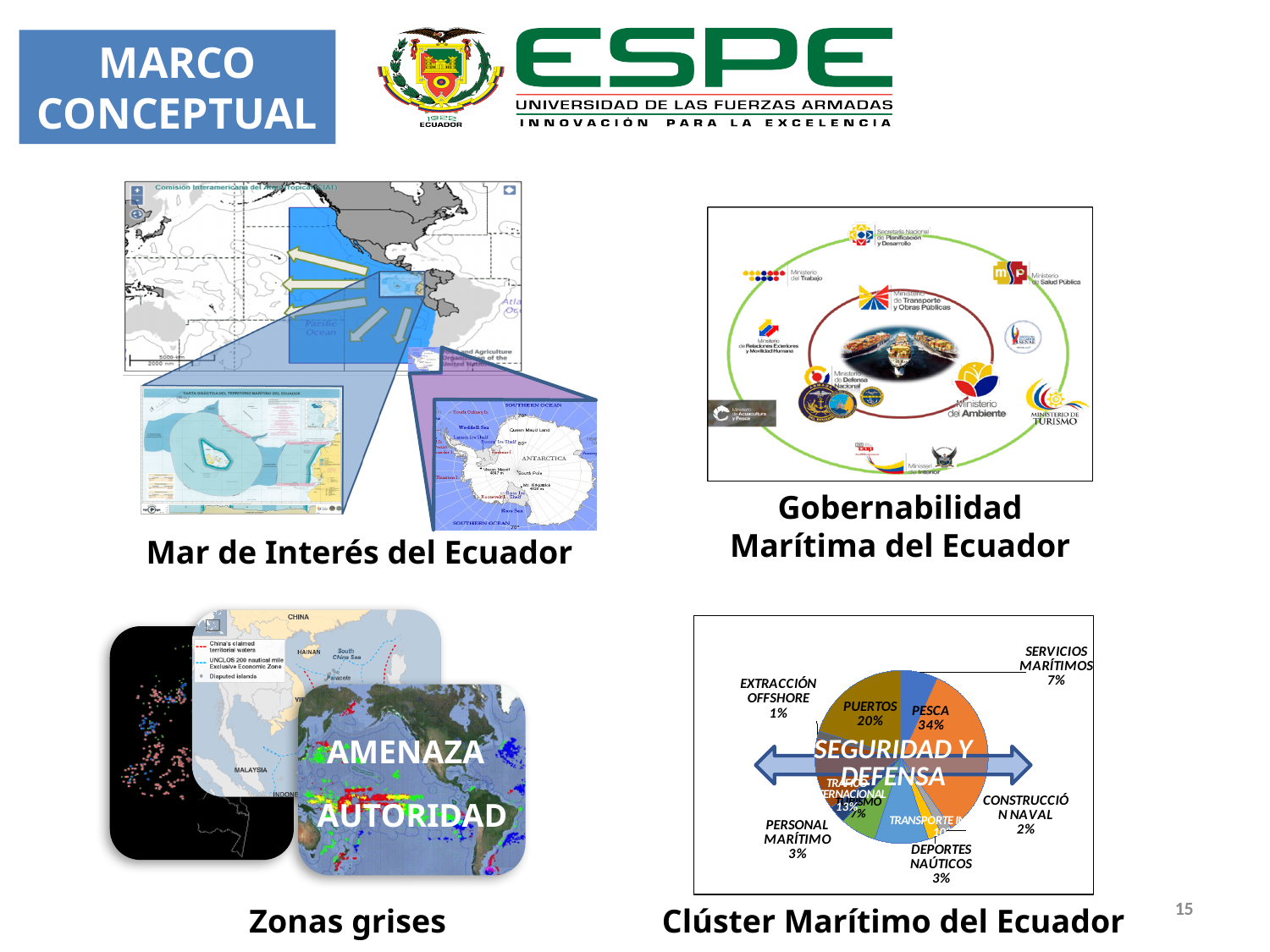
In the 'Clúster Marítimo del Ecuador' pie chart, what share does SERVICIOS MARÍTIMOS have? 7% In the 'Clúster Marítimo del Ecuador' pie chart, which category has the smallest share? EXTRACCIÓN OFFSHORE In the 'Clúster Marítimo del Ecuador' pie chart, which category has the largest share? PESCA In the 'Clúster Marítimo del Ecuador' pie chart, what share does CONSTRUCCIÓN NAVAL have? 2% What text is overlaid across the centre of the 'Clúster Marítimo del Ecuador' pie chart? SEGURIDAD Y DEFENSA In the 'Clúster Marítimo del Ecuador' pie chart, what share does DEPORTES NÁUTICOS have? 3% In the 'Clúster Marítimo del Ecuador' pie chart, what share does PUERTOS have? 20% In the 'Clúster Marítimo del Ecuador' pie chart, what share does PESCA have? 34% In the 'Clúster Marítimo del Ecuador' pie chart, what share does EXTRACCIÓN OFFSHORE have? 1% In the 'Clúster Marítimo del Ecuador' pie chart, how many percentage points larger is PESCA than PUERTOS? 14 What kind of chart is shown under the title 'Clúster Marítimo del Ecuador'? pie chart In the 'Clúster Marítimo del Ecuador' pie chart, which is larger: PUERTOS or SERVICIOS MARÍTIMOS? PUERTOS